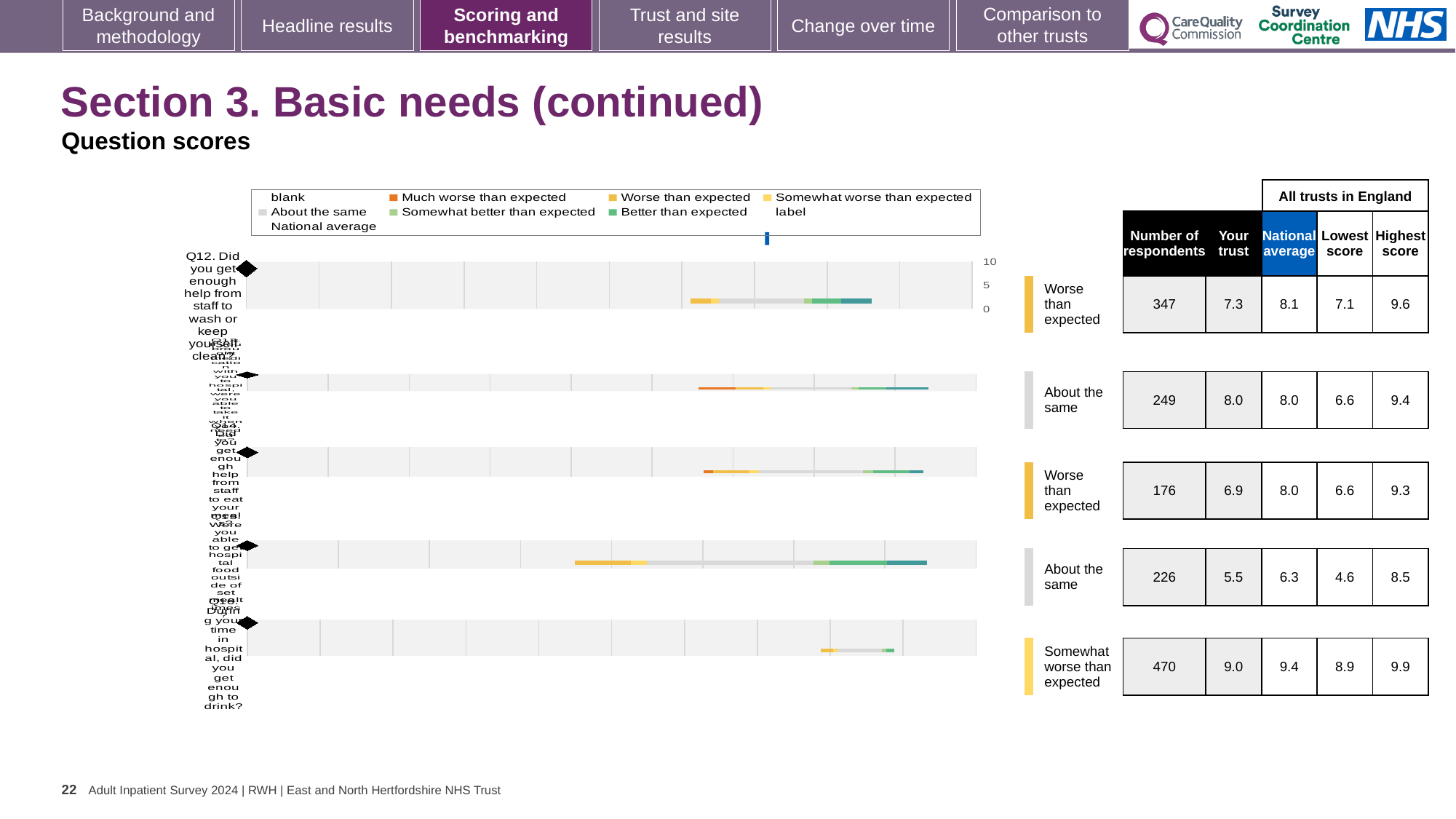
How many questions (rows) are plotted in the question scores chart? 5 How many respondents answered Q12 (help from staff to wash or keep yourself clean)? 347 For Q14 (help from staff to eat your meals), which is larger: the 'Your trust' score or the national average? National average For Q12, how much higher is the national average than the 'Your trust' score? 0.8 What is the highest score among all trusts in England for the last question row (Q16, enough to drink)? 9.9 What is the 'Your trust' score for Q12 (help from staff to wash or keep yourself clean)? 7.3 Which question row has the lowest 'Your trust' score? Q15 (hospital food outside of set meal times), 5.5 What kind of chart is used to show the question scores on this slide? bar chart Which question row has the highest 'Your trust' score? Q16 (enough to drink), 9.0 What is the national average for the fourth question row (hospital food outside of set meal times)? 6.3 How many entries does the legend of the question scores chart list? 9 What benchmark category is shown for the first question row (Q12)? Worse than expected